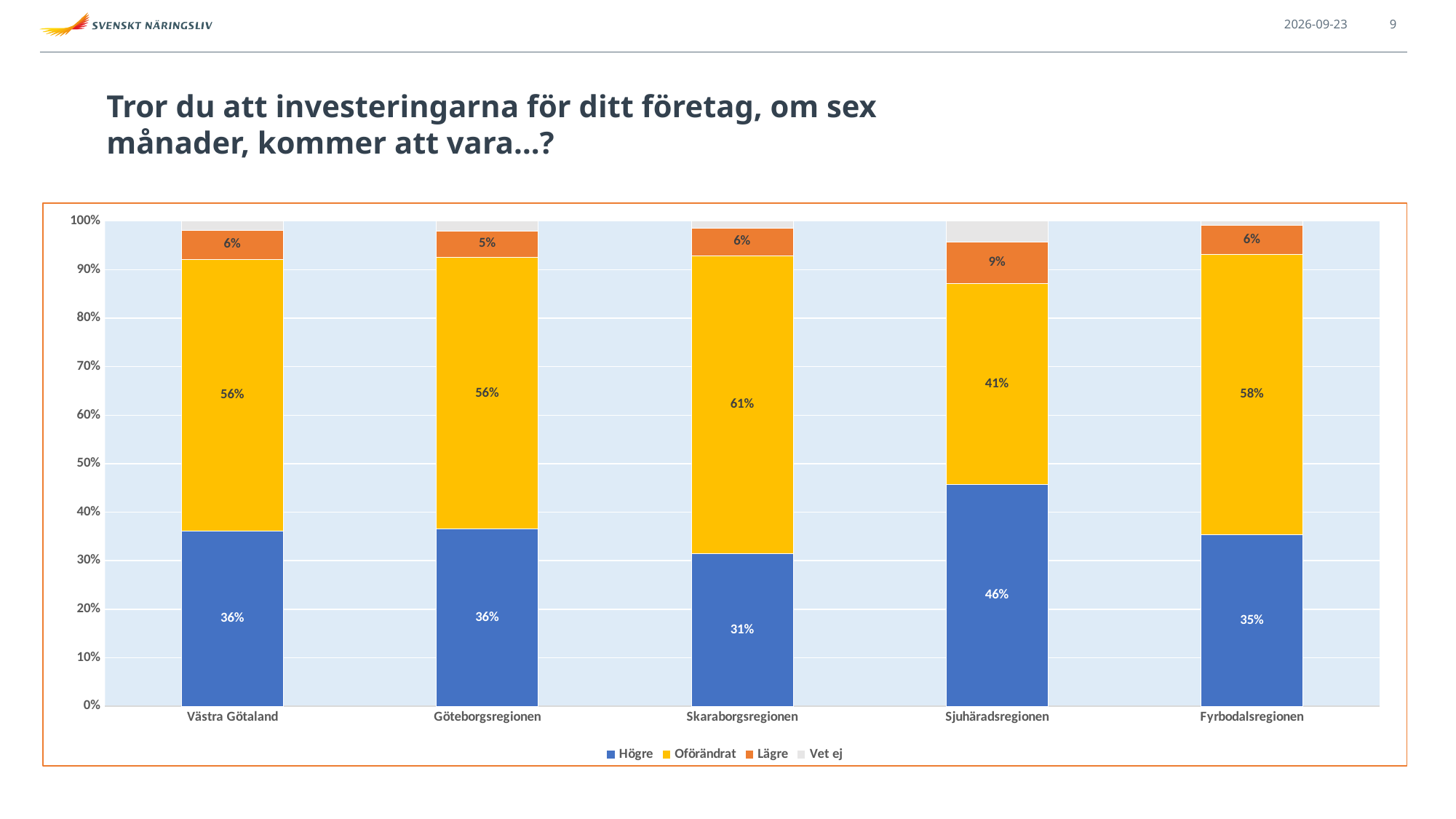
How many regions are shown on the x axis? 5 How many series does the legend list? 4 Which region has the lowest Oförändrat share? Sjuhäradsregionen What is the Lägre share for Göteborgsregionen? 5% Which is larger: the Oförändrat share in Fyrbodalsregionen or in Västra Götaland? Fyrbodalsregionen Which legend entry is shown in blue? Högre What is the Oförändrat share for Skaraborgsregionen? 61% What kind of chart is shown on the slide? Stacked bar chart Which region has the highest Högre share? Sjuhäradsregionen What percentage of respondents in Sjuhäradsregionen answered Högre? 46% Which region has the highest Lägre share? Sjuhäradsregionen What is the difference between the Högre share in Sjuhäradsregionen and in Skaraborgsregionen? 15 percentage points